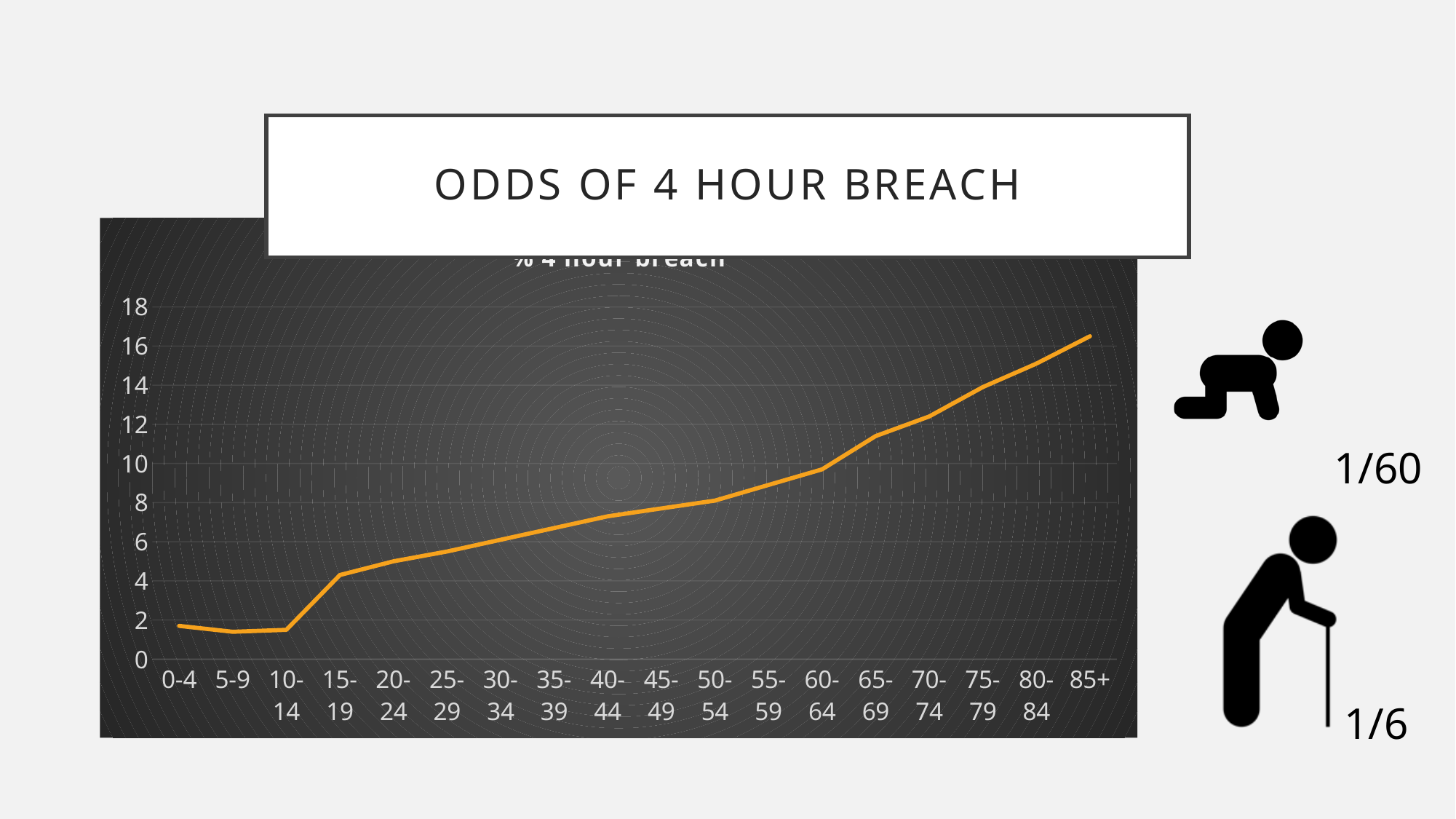
Is the value for the 85+ age group greater or less than 14? greater Which age group has the highest value? 85+ Is the value for the 60-64 age group greater or less than 8? greater Is the value for the 0-4 age group greater or less than 4? less Do the values generally rise or fall as age increases along the x axis? rise What kind of chart is shown on the slide? line chart What colour is the plotted line? orange Which has the larger value, the 30-34 age group or the 60-64 age group? 60-64 How many age-group categories are shown on the x axis? 18 What is the highest tick value shown on the y axis? 18